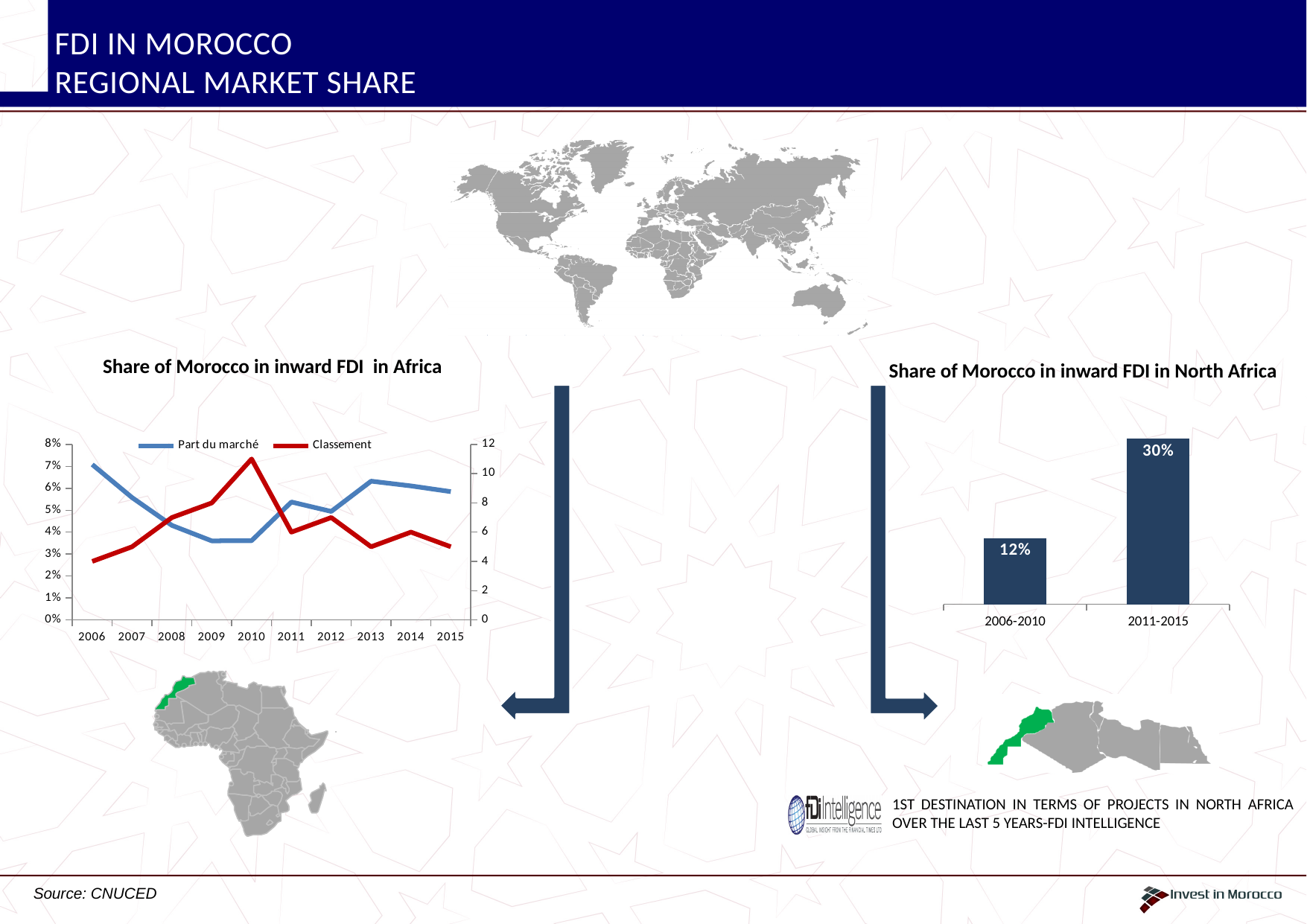
In the chart 'Share of Morocco in inward FDI in Africa', which series is drawn in red? Classement In the chart 'Share of Morocco in inward FDI in North Africa', what is the value for 2011-2015? 30% What kind of chart is 'Share of Morocco in inward FDI in North Africa'? Bar chart How many series does the legend of the chart 'Share of Morocco in inward FDI in Africa' list? 2 In the chart 'Share of Morocco in inward FDI in Africa', is the 'Classement' value for 2010 greater or less than 10? greater In the chart 'Share of Morocco in inward FDI in Africa', how many years are shown on the x axis? 10 In the chart 'Share of Morocco in inward FDI in North Africa', what is the difference between the 2011-2015 value and the 2006-2010 value? 18% In the chart 'Share of Morocco in inward FDI in North Africa', how many bars are plotted? 2 In the chart 'Share of Morocco in inward FDI in North Africa', what is the value for 2006-2010? 12% What kind of chart is 'Share of Morocco in inward FDI in Africa'? Line chart In the chart 'Share of Morocco in inward FDI in North Africa', which period has the higher value? 2011-2015 In the chart 'Share of Morocco in inward FDI in Africa', is the 'Part du marché' value for 2006 greater or less than 6%? greater